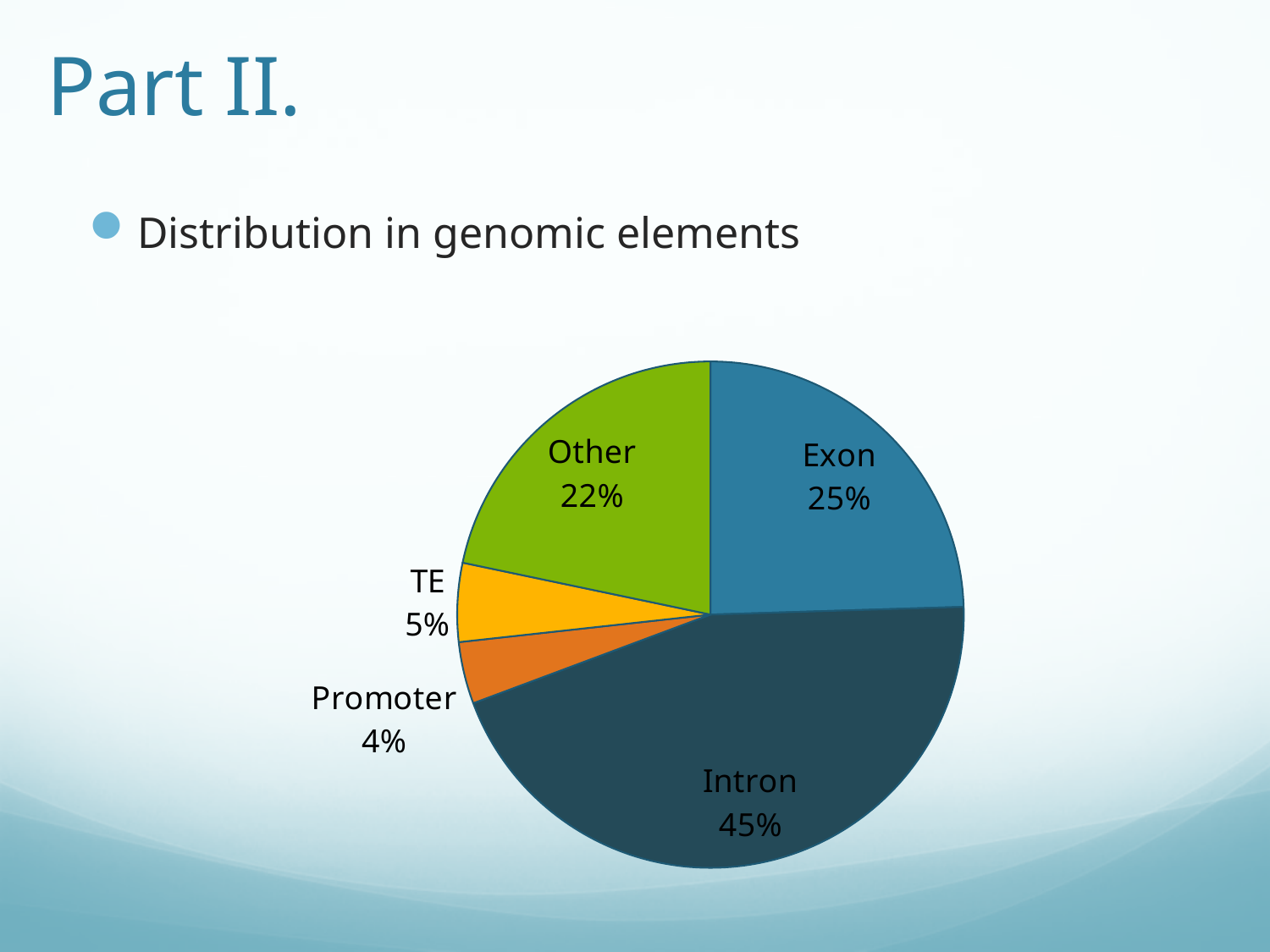
Which category has the smallest slice of the pie? Promoter What percentage of the pie is TE? 5% What kind of chart is shown on the slide? pie chart What is the difference in percentage points between Intron and Exon? 20 Which is larger, the Other slice or the Exon slice? Exon What percentage of the pie is Exon? 25% Which category has the largest slice of the pie? Intron What percentage of the pie is Promoter? 4% What colour is the Intron slice? dark teal How many slices does the pie chart have? 5 What percentage of the pie is Other? 22% What percentage of the pie is Intron? 45%